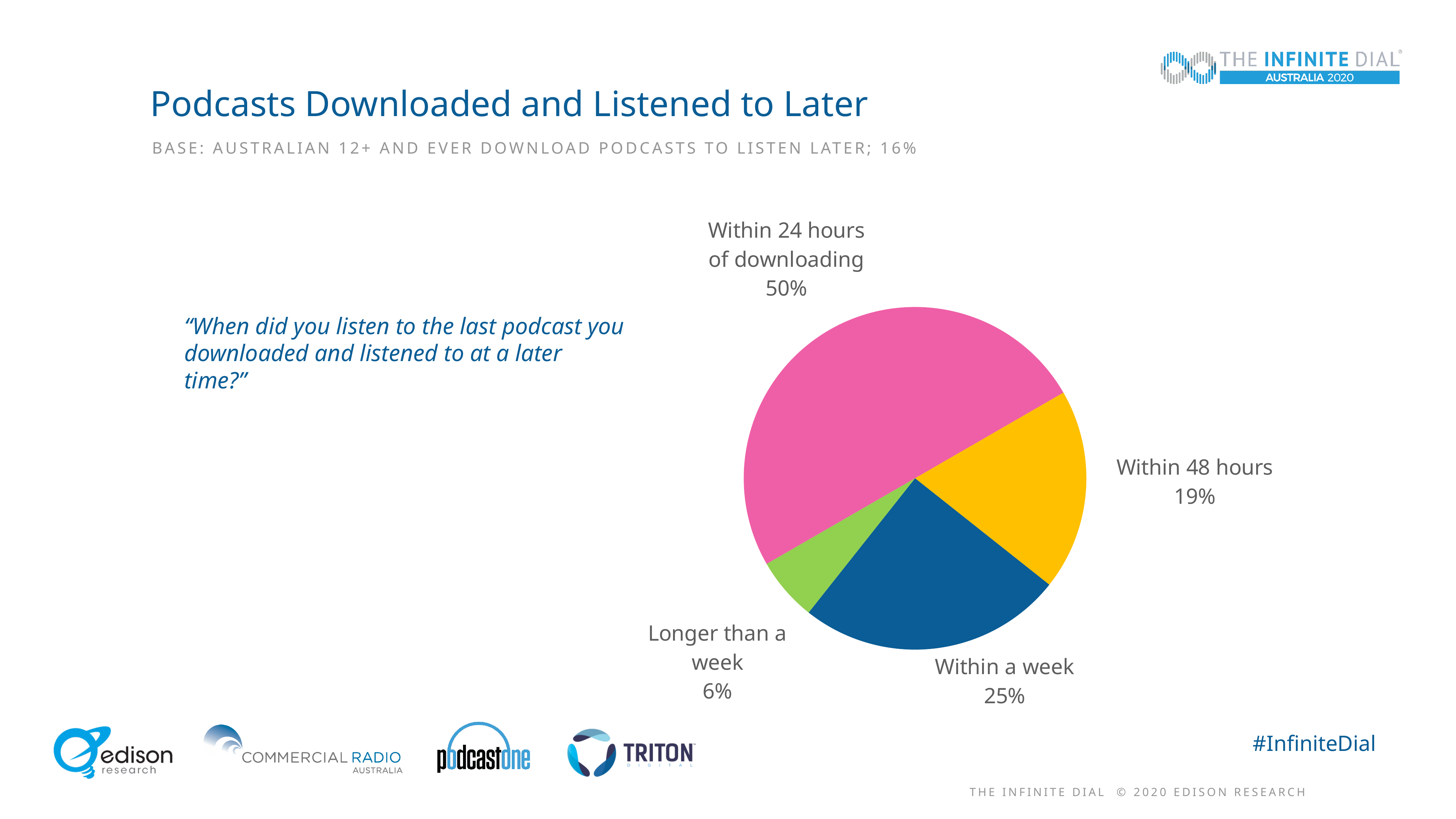
What kind of chart is shown on the slide? Pie chart Which category has the smallest share of the pie? Longer than a week What percentage of respondents listened within a week? 25% What percentage of respondents listened longer than a week after downloading? 6% Which is larger: 'Within 48 hours' or 'Within a week'? Within a week Which category has the largest share of the pie? Within 24 hours of downloading What colour is the 'Within a week' slice? Dark blue How many slices does the pie chart have? 4 What percentage of respondents listened within 48 hours? 19% What is the title of the chart on the slide? Podcasts Downloaded and Listened to Later What is the difference in percentage points between 'Within 24 hours of downloading' and 'Within a week'? 25 What percentage of respondents listened within 24 hours of downloading? 50%